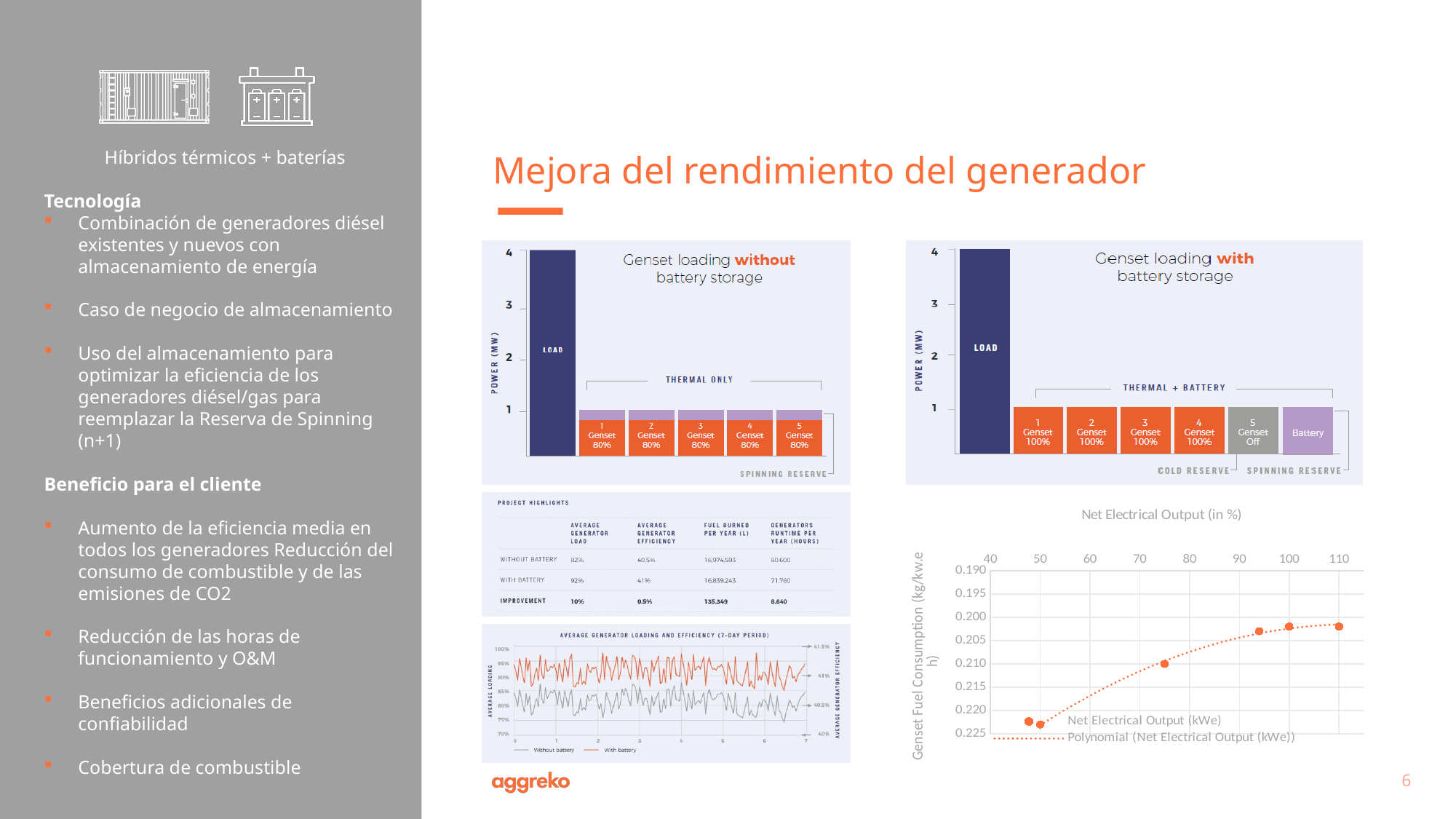
In the 'Genset loading with battery storage' chart, at what loading percentage is Genset 1 shown? 100% What is the name of the second legend entry in the 'Net Electrical Output (in %)' chart? Polynomial (Net Electrical Output (kWe)) In the 'Genset loading without battery storage' chart, how many gensets are shown? 5 In the 'Net Electrical Output (in %)' chart, is the fuel consumption value for the point at about 100% output greater or less than 0.205? less In the 'Net Electrical Output (in %)' chart, does genset fuel consumption rise or fall as net electrical output increases along the x axis? fall In the 'Genset loading without battery storage' chart, at what loading percentage is each genset shown? 80% In the 'Net Electrical Output (in %)' chart, is the fuel consumption value for the point at about 50% output greater or less than 0.220? greater How many data points are plotted in the 'Net Electrical Output (in %)' scatter chart? 5 What kind of chart is the 'Net Electrical Output (in %)' chart at the bottom right of the slide? scatter chart How many entries does the legend of the 'Net Electrical Output (in %)' chart list? 2 In the 'Net Electrical Output (in %)' chart, is the fuel consumption value for the point at about 110% output greater or less than 0.210? less What is the y-axis label of the 'Net Electrical Output (in %)' chart? Genset Fuel Consumption (kg/kw.e h)